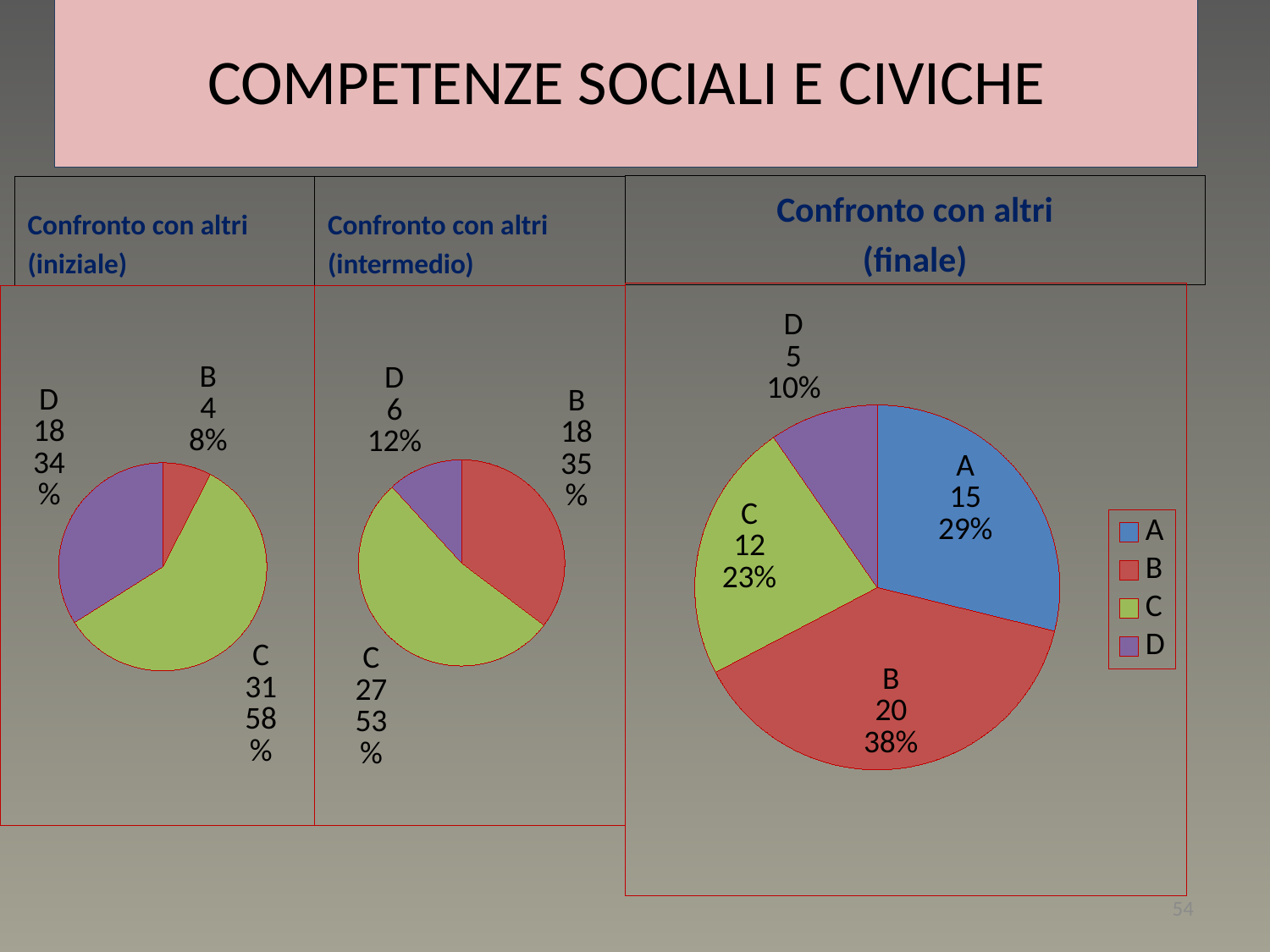
How many slices does the 'Confronto con altri (finale)' chart have? 4 How many entries does the legend of the 'Confronto con altri (finale)' chart list? 4 What kind of chart is used for 'Confronto con altri (intermedio)'? Pie chart In the 'Confronto con altri (iniziale)' chart, which is larger, the value for D or the value for B? D In the 'Confronto con altri (finale)' chart, what is the difference between the values for B and D? 15 In the 'Confronto con altri (finale)' chart, what percentage share does category A have? 29% In the 'Confronto con altri (intermedio)' chart, what percentage share does category D have? 12% In the 'Confronto con altri (iniziale)' chart, which category has the smallest slice? B In the 'Confronto con altri (finale)' chart, what is the value for category B? 20 In the 'Confronto con altri (iniziale)' chart, what is the value for category C? 31 In the 'Confronto con altri (finale)' chart, which category has the largest slice? B In the 'Confronto con altri (intermedio)' chart, which category has the largest slice? C